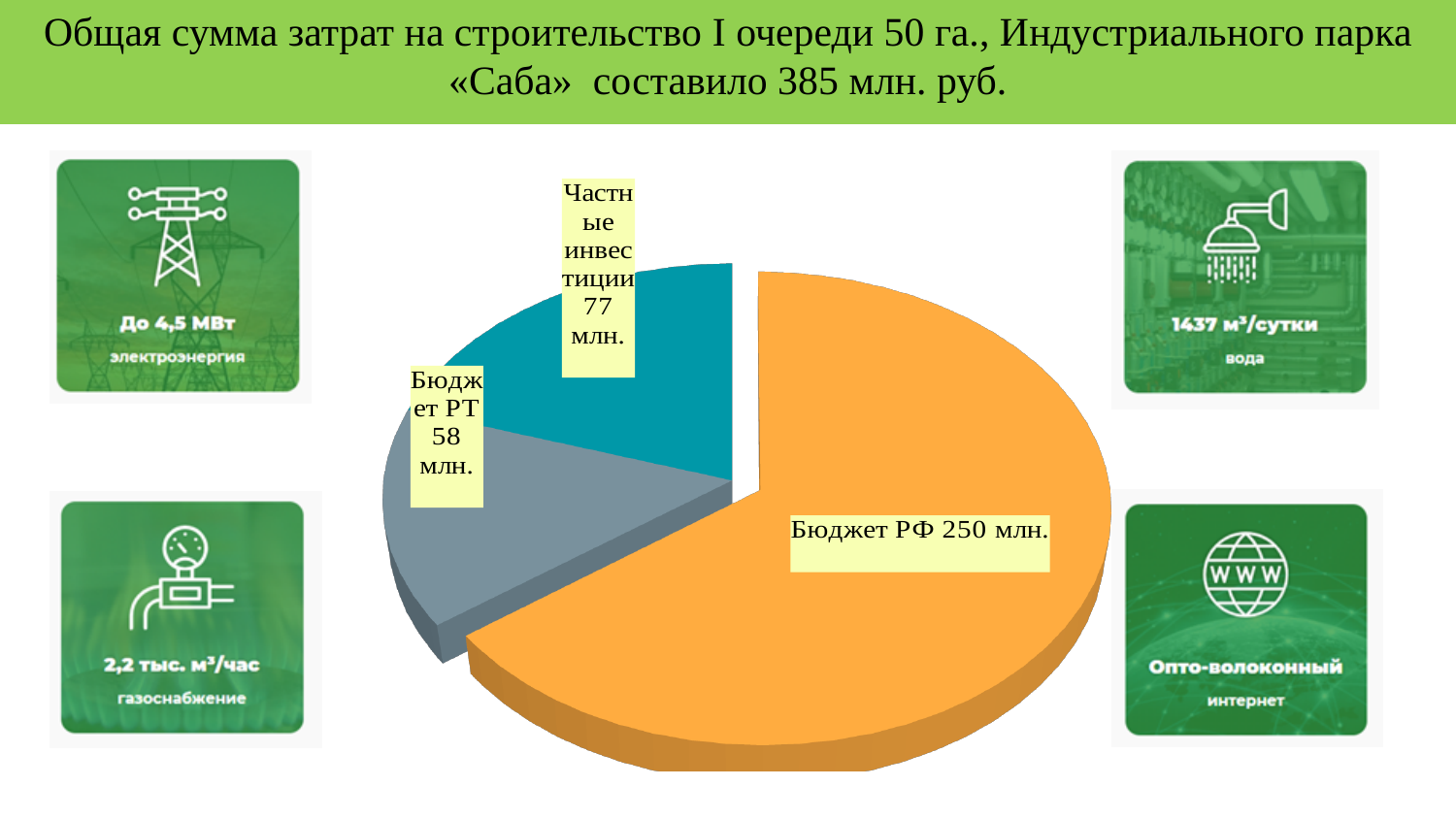
What is the difference between Бюджет РФ and Частные инвестиции? 173 млн. What is the value for Бюджет РФ? 250 млн. What share of the total do Частные инвестиции represent? 20% What is the value for Бюджет РТ? 58 млн. Which slice of the pie chart is the smallest? Бюджет РТ How many slices does the pie chart have? 3 Which is larger, Частные инвестиции or Бюджет РТ? Частные инвестиции What is the value for Частные инвестиции? 77 млн. What is the total of all three slices in the pie chart? 385 млн. Which slice of the pie chart is the largest? Бюджет РФ What is the difference between Частные инвестиции and Бюджет РТ? 19 млн. What kind of chart is shown on the slide? Pie chart